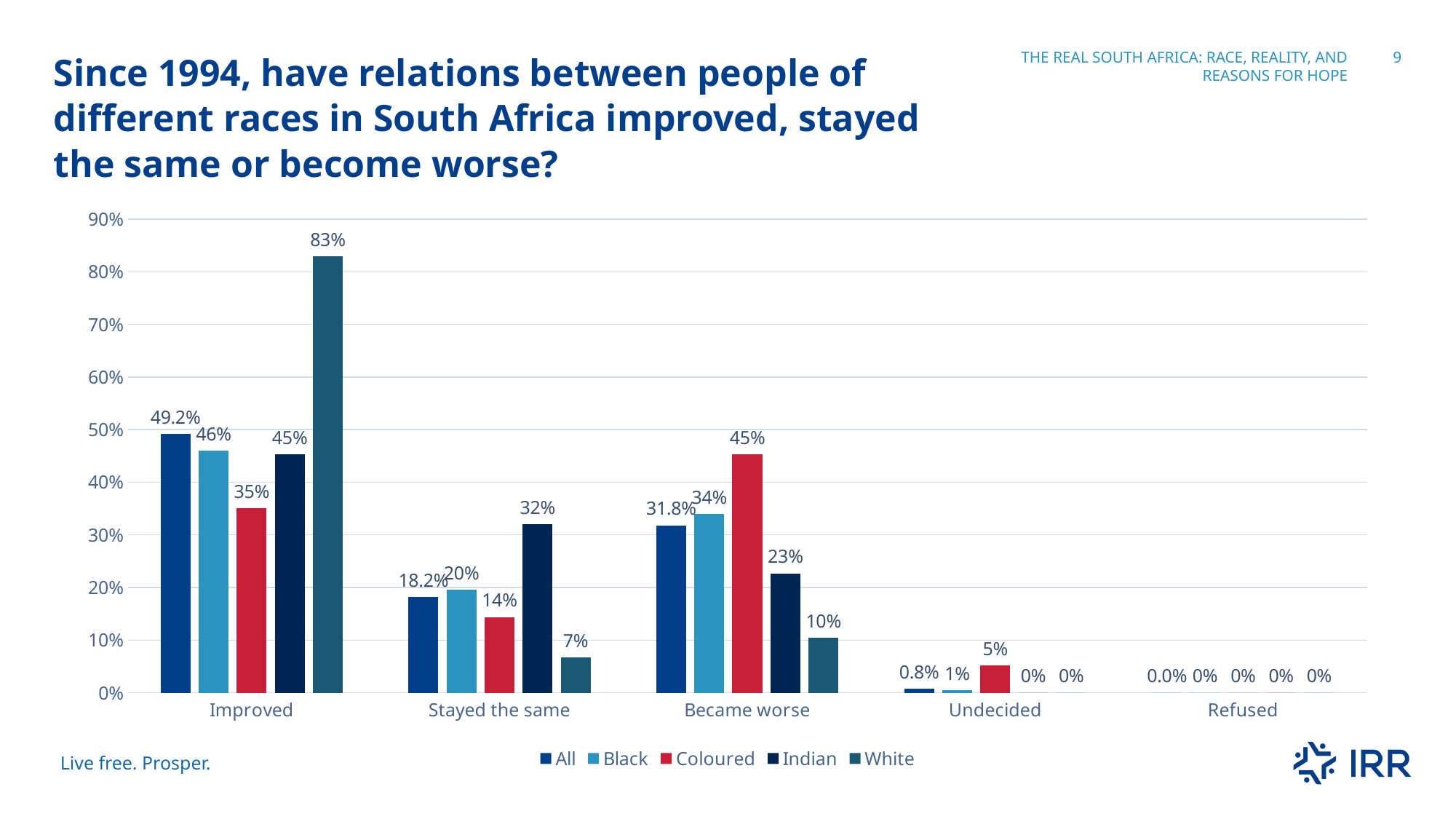
What percentage of Coloured respondents said relations stayed the same? 14% How many series does the legend list? 5 Which colour represents the Coloured series in the legend? red Is the value for Coloured respondents in the Improved category greater or less than 40%? less How many response categories are shown on the x axis? 5 What is the value for All respondents in the Became worse category? 31.8% Which group has the lowest value in the Became worse category? White Which is larger: the Indian value for Stayed the same or the Black value for Stayed the same? Indian What is the difference between the Coloured and Indian values in the Became worse category? 22% Which group has the highest value in the Improved category? White What percentage of White respondents said relations have improved? 83% What kind of chart is shown on the slide? bar chart